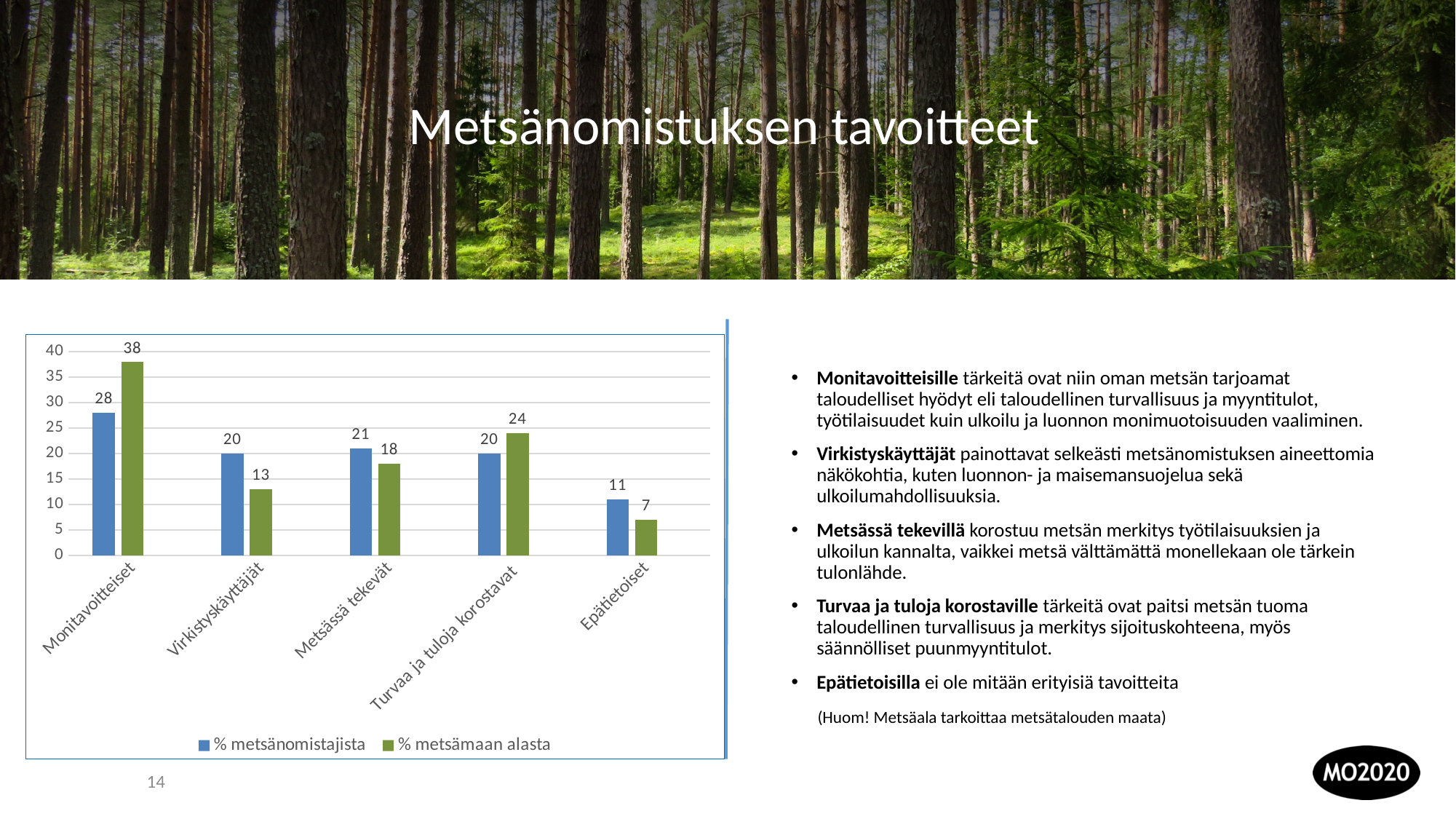
What is the value of "% metsänomistajista" for Monitavoitteiset? 28 What kind of chart is shown on the slide? Bar chart What is the difference between "% metsämaan alasta" and "% metsänomistajista" for Monitavoitteiset? 10 What is the value of "% metsämaan alasta" for Turvaa ja tuloja korostavat? 24 What colour are the bars for the "% metsämaan alasta" series? Green Which category has the lowest value for "% metsänomistajista"? Epätietoiset How many categories are shown on the x axis of the chart? 5 Is the value of "% metsämaan alasta" for Metsässä tekevät greater or less than 15? greater For Virkistyskäyttäjät, which is larger: "% metsänomistajista" or "% metsämaan alasta"? % metsänomistajista What is the value of "% metsämaan alasta" for Epätietoiset? 7 Which category has the highest value for "% metsämaan alasta"? Monitavoitteiset How many series does the chart legend list? 2